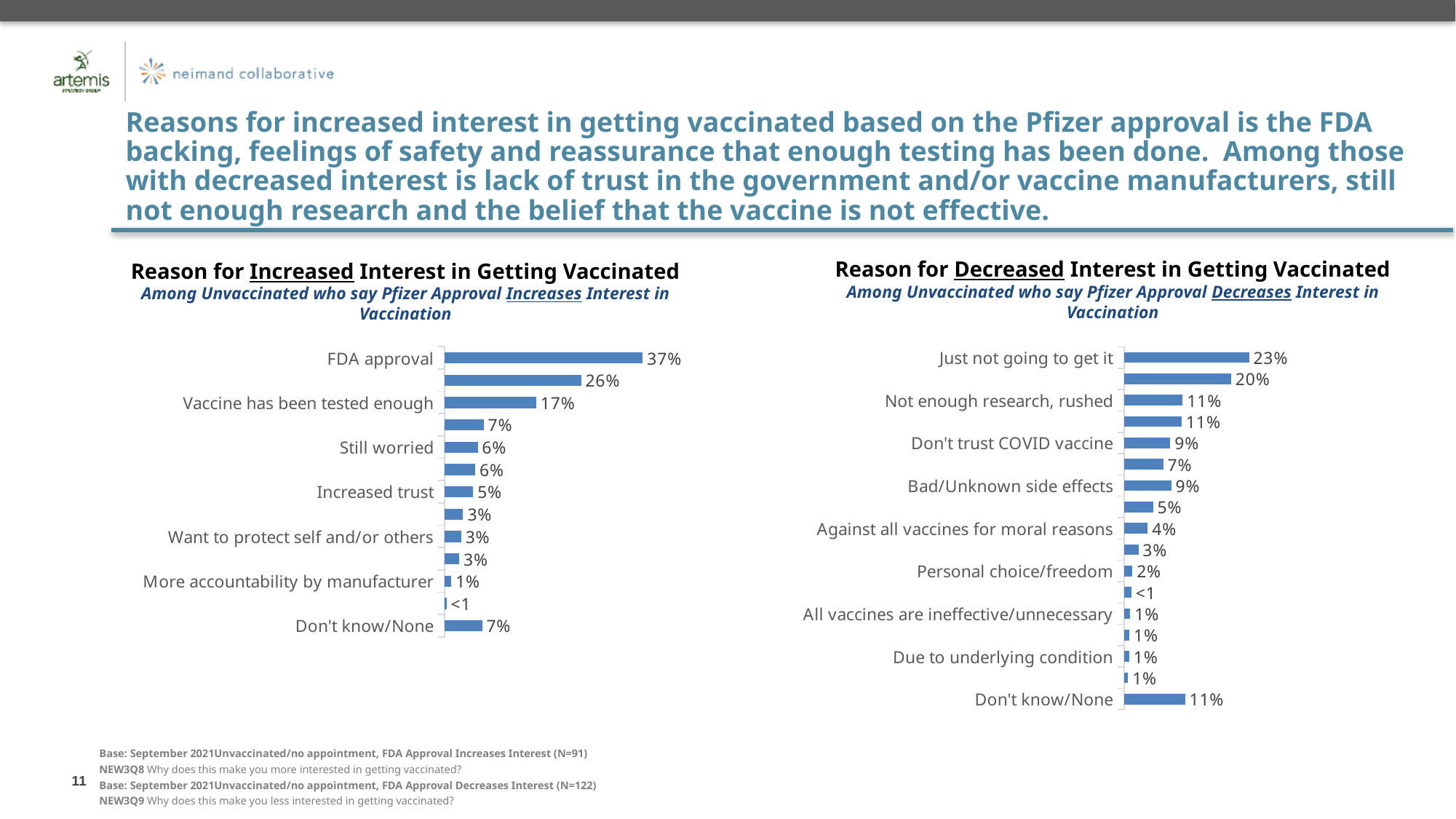
In the 'Reason for Increased Interest in Getting Vaccinated' chart, which is larger: Still worried or Increased trust? Still worried In the 'Reason for Increased Interest in Getting Vaccinated' chart, what is the difference between FDA approval and 'Vaccine has been tested enough'? 20 percentage points What type of chart is the 'Reason for Decreased Interest in Getting Vaccinated' chart? Bar chart In the 'Reason for Decreased Interest in Getting Vaccinated' chart, which labeled reason has the highest value? Just not going to get it In the 'Reason for Increased Interest in Getting Vaccinated' chart, what is the value for FDA approval? 37% In the 'Reason for Decreased Interest in Getting Vaccinated' chart, which is larger: 'Against all vaccines for moral reasons' or 'Personal choice/freedom'? Against all vaccines for moral reasons In the 'Reason for Increased Interest in Getting Vaccinated' chart, which labeled reason has the highest value? FDA approval In the 'Reason for Increased Interest in Getting Vaccinated' chart, what is the value for 'Vaccine has been tested enough'? 17% In the 'Reason for Increased Interest in Getting Vaccinated' chart, what is the value for 'More accountability by manufacturer'? 1% In the 'Reason for Decreased Interest in Getting Vaccinated' chart, what is the value for 'Not enough research, rushed'? 11% In the 'Reason for Decreased Interest in Getting Vaccinated' chart, what is the value for 'Just not going to get it'? 23% In the 'Reason for Decreased Interest in Getting Vaccinated' chart, what is the difference between 'Just not going to get it' and 'Don't trust COVID vaccine'? 14 percentage points